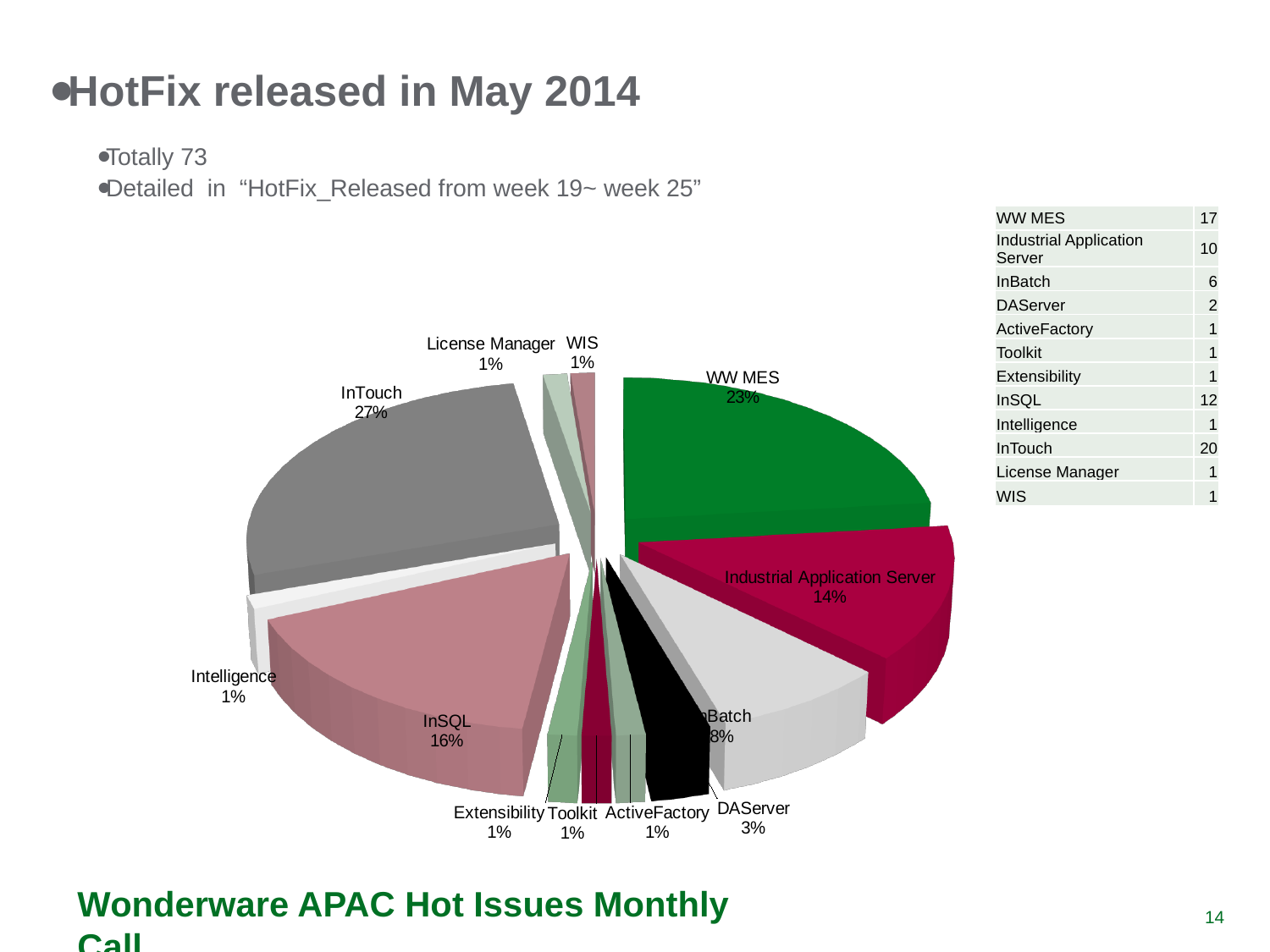
Which is larger, the slice for WW MES or the slice for InSQL? WW MES Which category has the largest slice of the pie? InTouch What colour is the WW MES slice of the pie? Green How many slices does the pie chart have? 12 What percentage is shown for DAServer? 3% What share of the pie does WW MES represent? 23% What percentage is shown for InSQL? 16% What share of the pie does InTouch represent? 27% What type of chart is shown on the slide? Pie chart What is the difference in percentage points between InTouch and Industrial Application Server? 13 According to the table next to the chart, how many HotFixes were released for InTouch? 20 What percentage is shown for Industrial Application Server? 14%